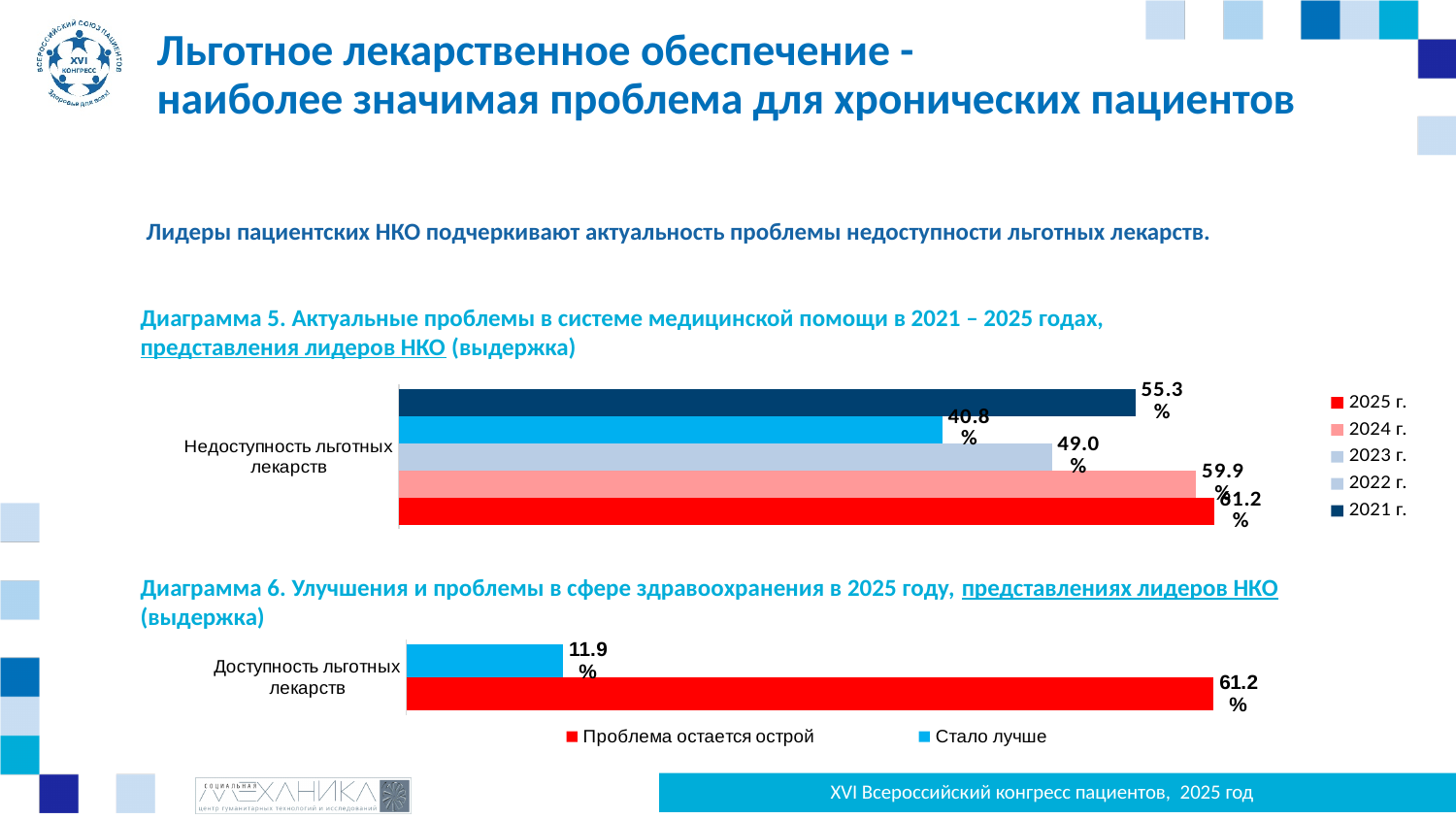
In Диаграмма 6, what is the difference between Проблема остается острой and Стало лучше? 49.3% How many series does the legend of Диаграмма 5 list? 5 In Диаграмма 5, which is larger: the value for 2023 г. or for 2021 г.? 2021 г. In Диаграмма 6, what is the value for Стало лучше? 11.9% In Диаграмма 5, which year has the highest value? 2025 г. In Диаграмма 6, what is the value for Проблема остается острой? 61.2% In Диаграмма 5, what is the value for 2021 г. for Недоступность льготных лекарств? 55.3% In Диаграмма 5, what is the difference between the 2025 г. and 2022 г. values? 20.4% What kind of chart is Диаграмма 6? Bar chart In Диаграмма 5, which year has the lowest value? 2022 г. In Диаграмма 5, what is the value for 2022 г.? 40.8% In Диаграмма 5, what is the value for 2025 г.? 61.2%